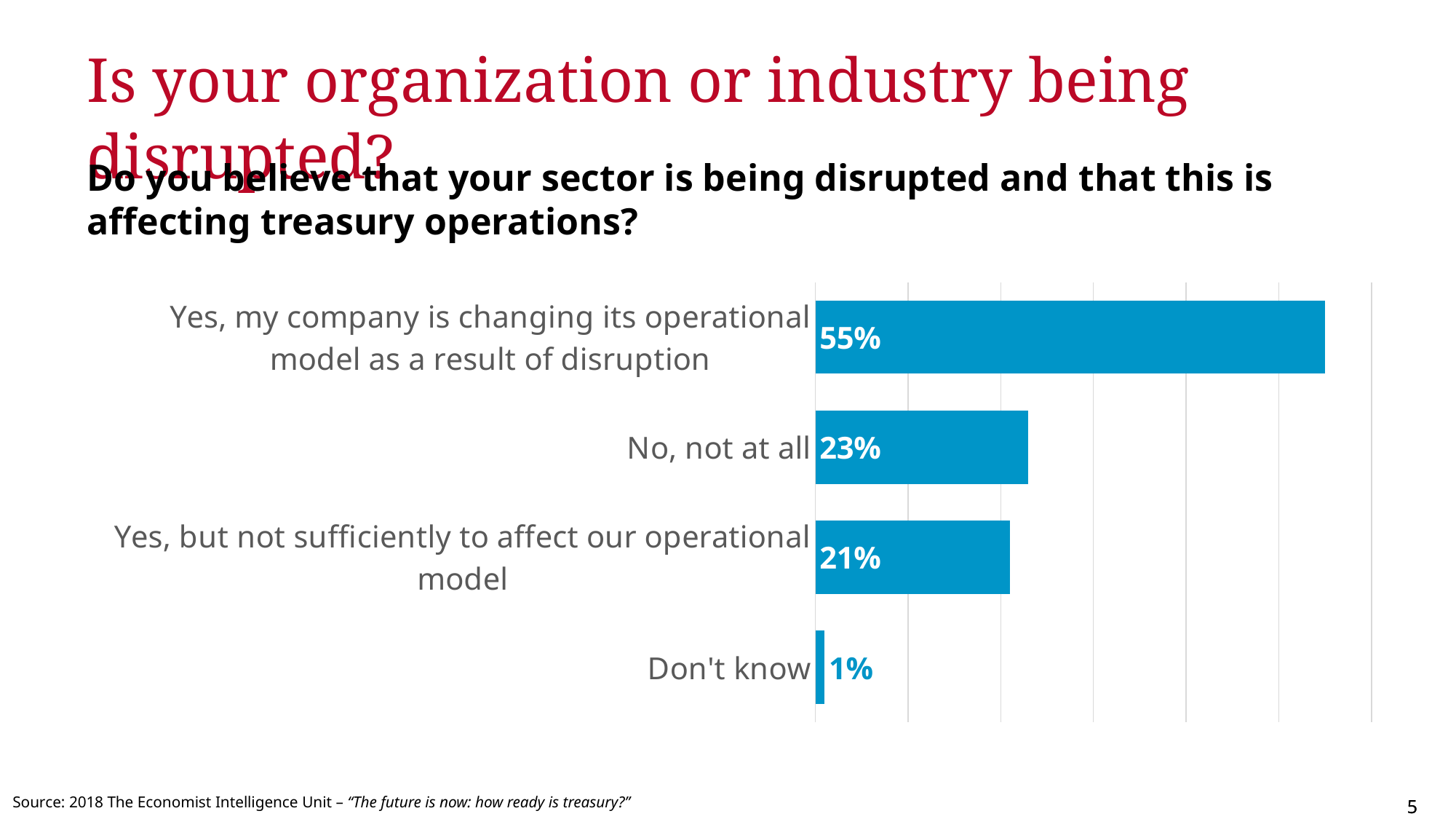
What percentage of respondents answered 'Don't know'? 1% What percentage of respondents answered 'No, not at all'? 23% Which is larger: the share for 'No, not at all' or for 'Yes, but not sufficiently to affect our operational model'? No, not at all What is the difference between 'No, not at all' and 'Yes, but not sufficiently to affect our operational model'? 2 percentage points What percentage of respondents said 'Yes, but not sufficiently to affect our operational model'? 21% Which response category has the highest percentage? Yes, my company is changing its operational model as a result of disruption What percentage of respondents said 'Yes, my company is changing its operational model as a result of disruption'? 55% What type of chart is shown on the slide? Bar chart Which response category has the lowest percentage? Don't know What is the source cited for the chart data? 2018 The Economist Intelligence Unit – "The future is now: how ready is treasury?" What is the difference in percentage points between 'Yes, my company is changing its operational model as a result of disruption' and 'No, not at all'? 32 percentage points How many response categories are shown in the chart? 4